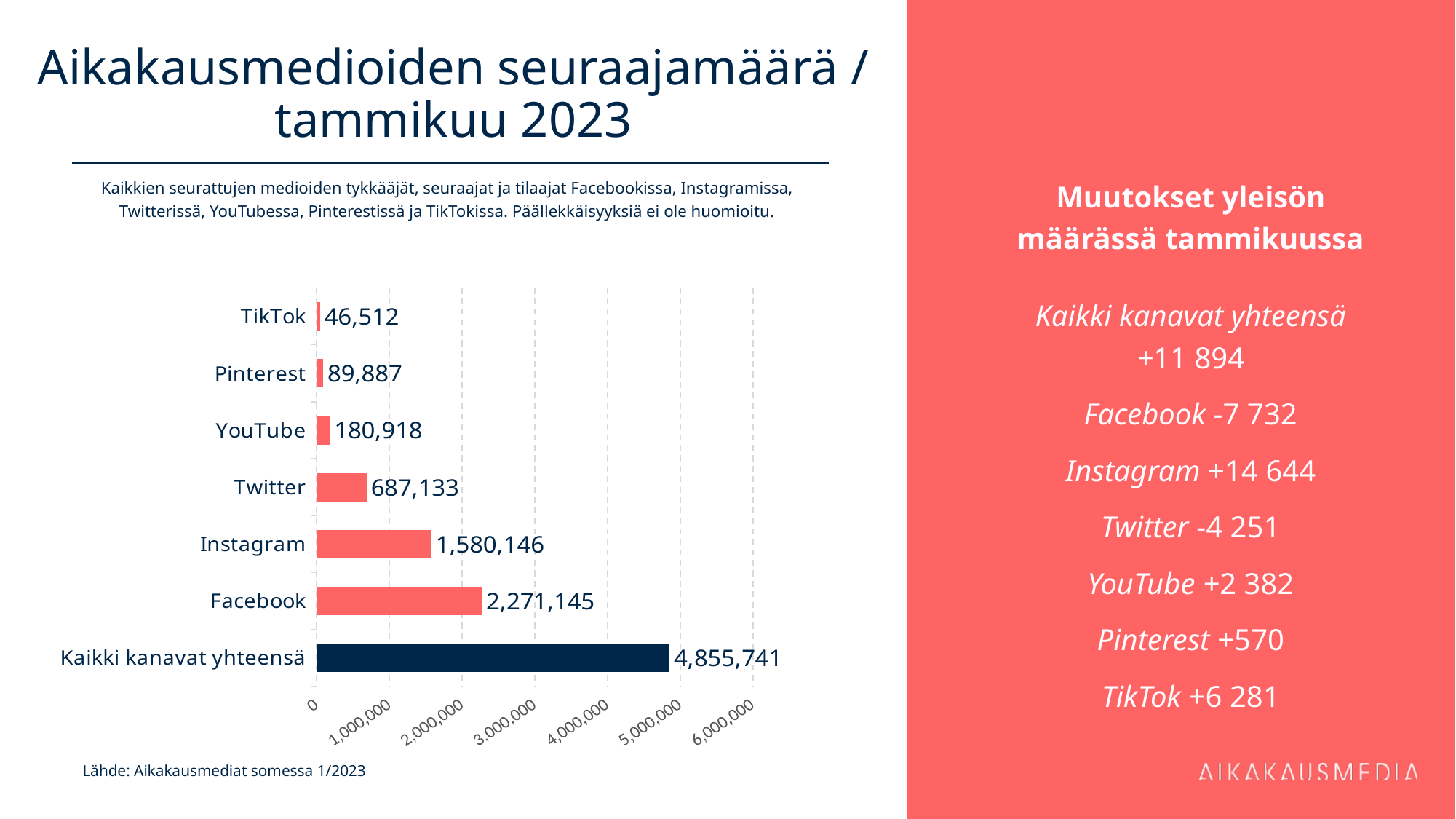
Which individual channel (excluding the total bar) has the highest value? Facebook What is the difference between the values for Twitter and YouTube? 506,215 What is the value for Facebook? 2,271,145 What kind of chart is shown on the slide? bar chart What is the value for Instagram? 1,580,146 Is the value for Facebook greater or less than 2,000,000? greater Which is larger, the value for Twitter or the value for YouTube? Twitter How many bars does the chart show? 7 Which category has the lowest value? TikTok What is the value for TikTok? 46,512 What is the difference between the values for Facebook and Instagram? 690,999 What is the value for Kaikki kanavat yhteensä? 4,855,741